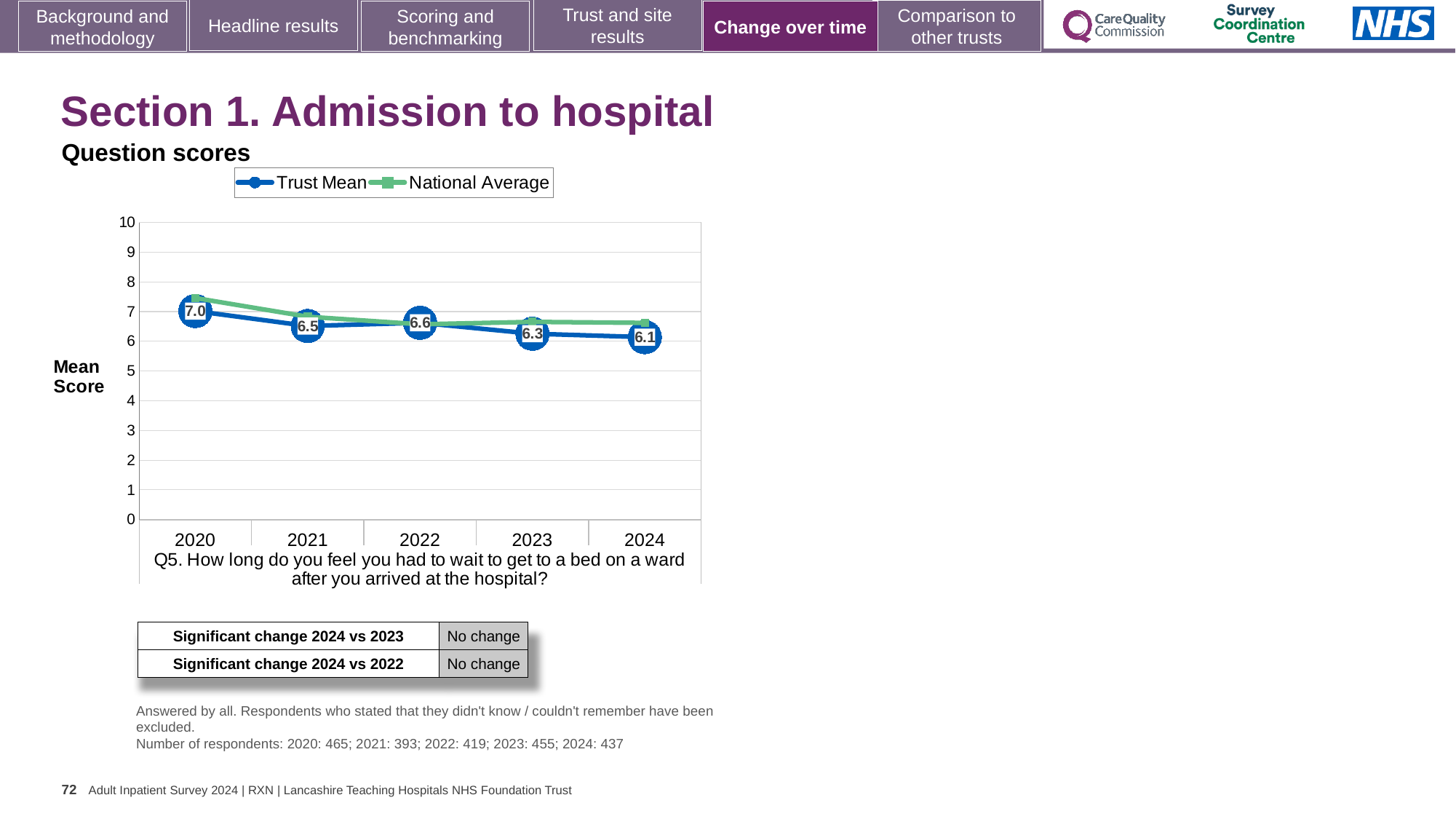
Is the National Average value for 2020 greater or less than 7? greater How many years are plotted on the x axis? 5 In which year is the Trust Mean score lowest? 2024 What is the Trust Mean score for 2022? 6.6 Which is larger, the Trust Mean score for 2021 or for 2022? 2022 In which year is the Trust Mean score highest? 2020 What is the difference between the Trust Mean scores for 2020 and 2024? 0.9 How many series does the legend list? 2 What is the Trust Mean score for 2024? 6.1 What is the Trust Mean score for 2020? 7.0 What kind of chart is shown? Line chart Does the Trust Mean score generally rise or fall from 2020 to 2024? Fall